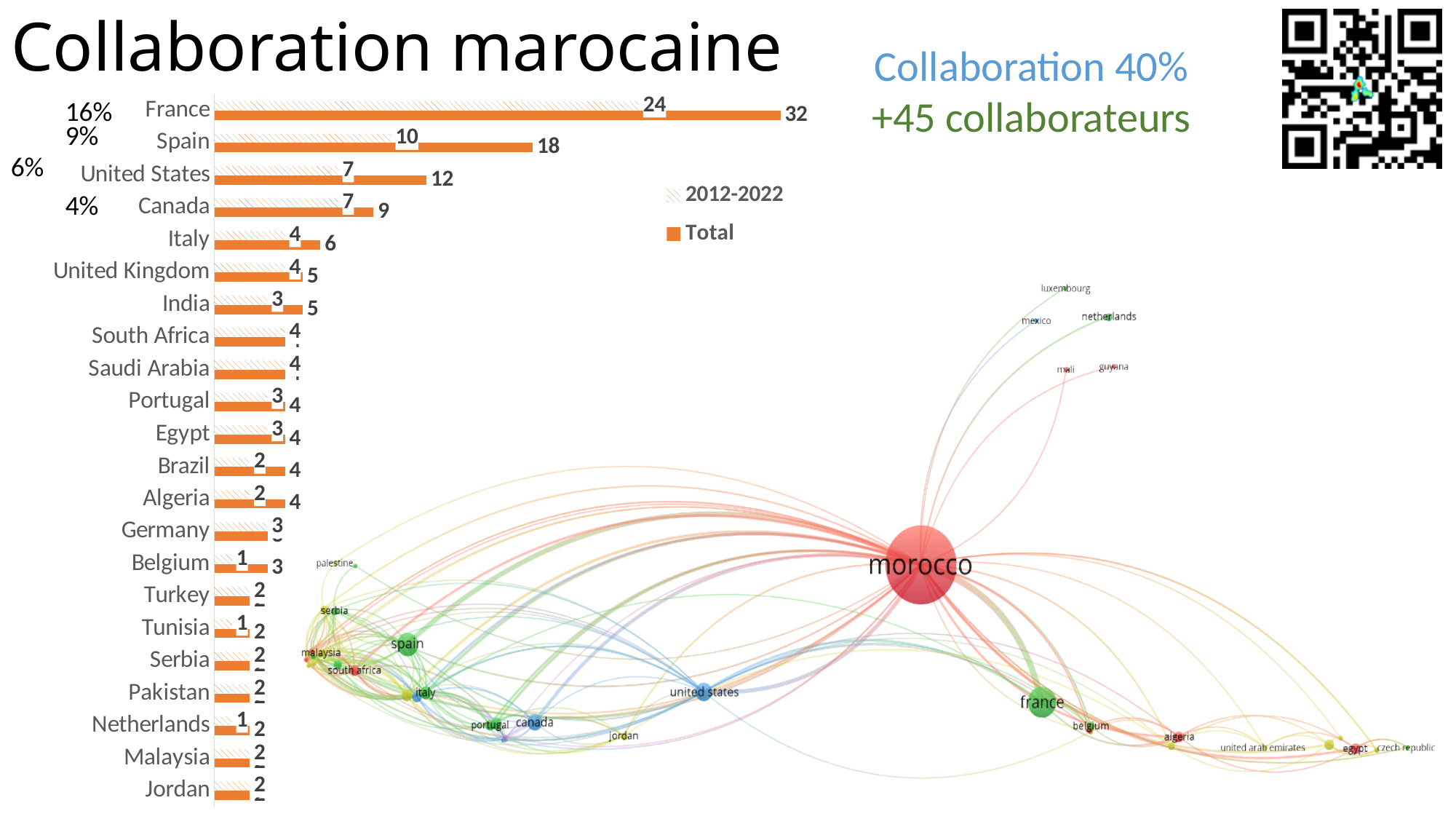
In the bar chart, what is the Total value for France? 32 In the bar chart, what is the 2012-2022 value for Spain? 10 How many countries are listed in the bar chart? 22 What are the two series named in the bar chart legend? 2012-2022 and Total In the bar chart, what is the 2012-2022 value for Belgium? 1 In the bar chart, which country has the highest Total value? France How many series does the bar chart legend list? 2 In the bar chart, what is the Total value for the United States? 12 In the bar chart, what is the difference between the Total and 2012-2022 values for France? 8 In the bar chart, what is the difference between the Total values for Spain and Canada? 9 In the bar chart, which has a larger Total value, Spain or the United States? Spain What type of chart shows the collaboration counts by country? Bar chart